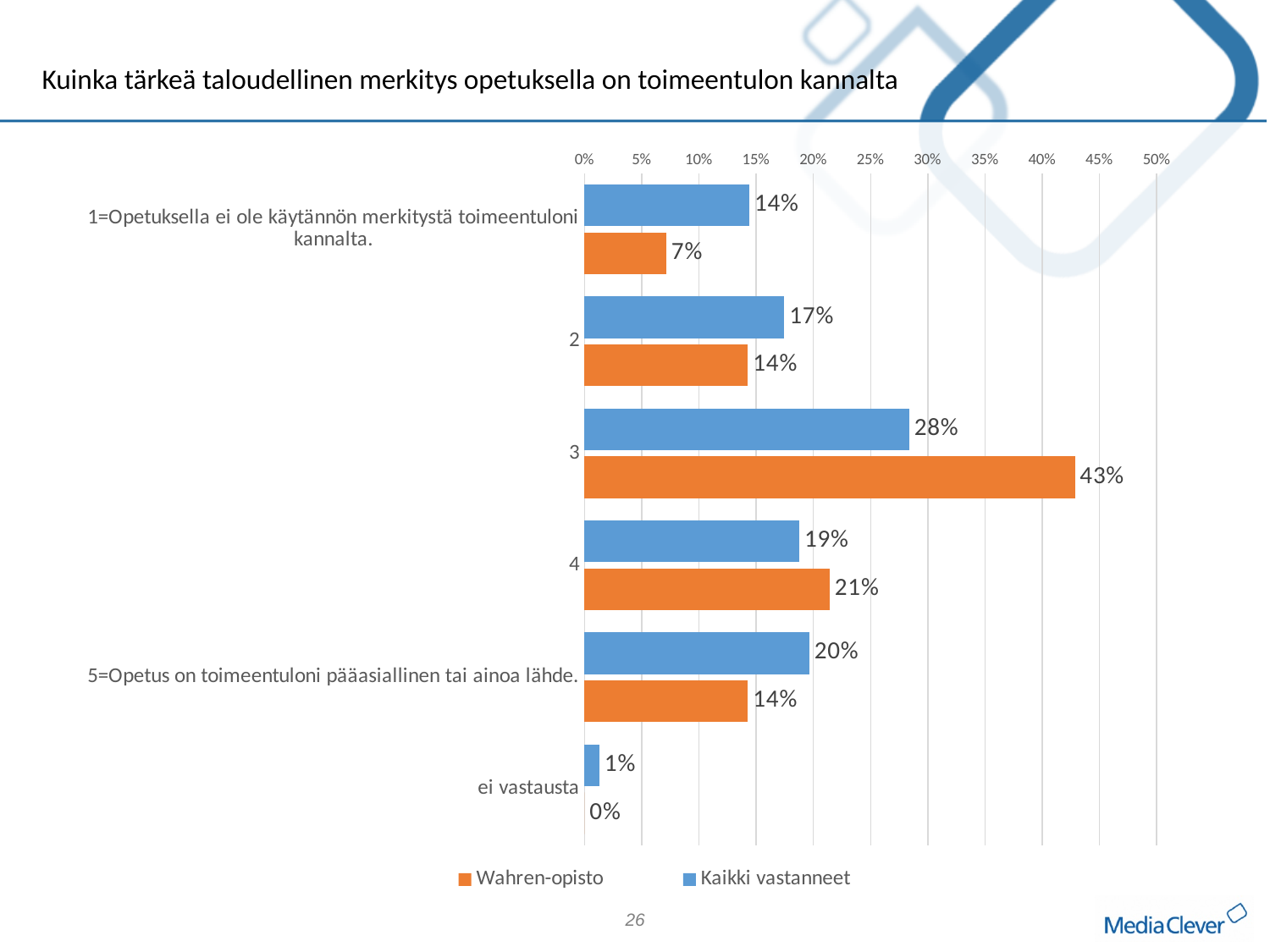
In category 4, which series has the larger value, Wahren-opisto or Kaikki vastanneet? Wahren-opisto Which category has the lowest value for Kaikki vastanneet? ei vastausta How many series does the legend list? 2 What is the value for Kaikki vastanneet in category 2? 17% What is the difference between the Wahren-opisto and Kaikki vastanneet values in category 3? 15% Which colour represents the Wahren-opisto series? Orange How many categories are shown on the chart? 6 What is the value for Wahren-opisto in category 3? 43% What kind of chart is shown on the slide? Bar chart Which category has the highest value for Wahren-opisto? 3 What is the value for Kaikki vastanneet in the category "5=Opetus on toimeentuloni pääasiallinen tai ainoa lähde."? 20% What is the value for Wahren-opisto in the category "1=Opetuksella ei ole käytännön merkitystä toimeentuloni kannalta."? 7%